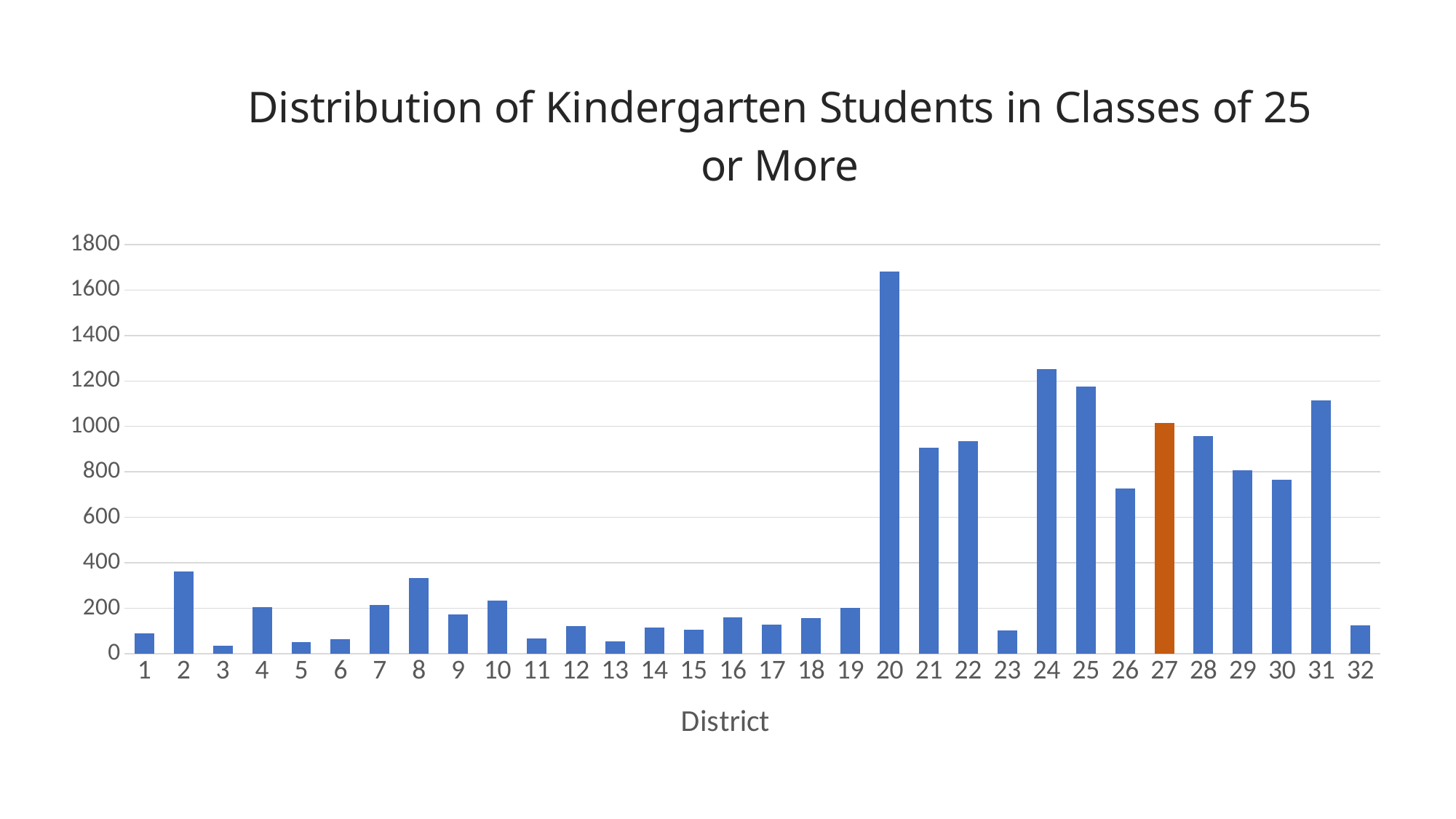
What is the title of the x axis? District Is the value for district 20 greater or less than 1600? greater Is the value for district 24 greater or less than 1200? greater Which district has the lowest number of kindergarten students in classes of 25 or more? 3 How many districts are shown on the x axis of the chart? 32 Which has a larger value, district 24 or district 25? district 24 Which district's bar is highlighted in orange? 27 Which district has the highest number of kindergarten students in classes of 25 or more? 20 What kind of chart is shown on the slide? bar chart Is the value for district 2 greater or less than 400? less